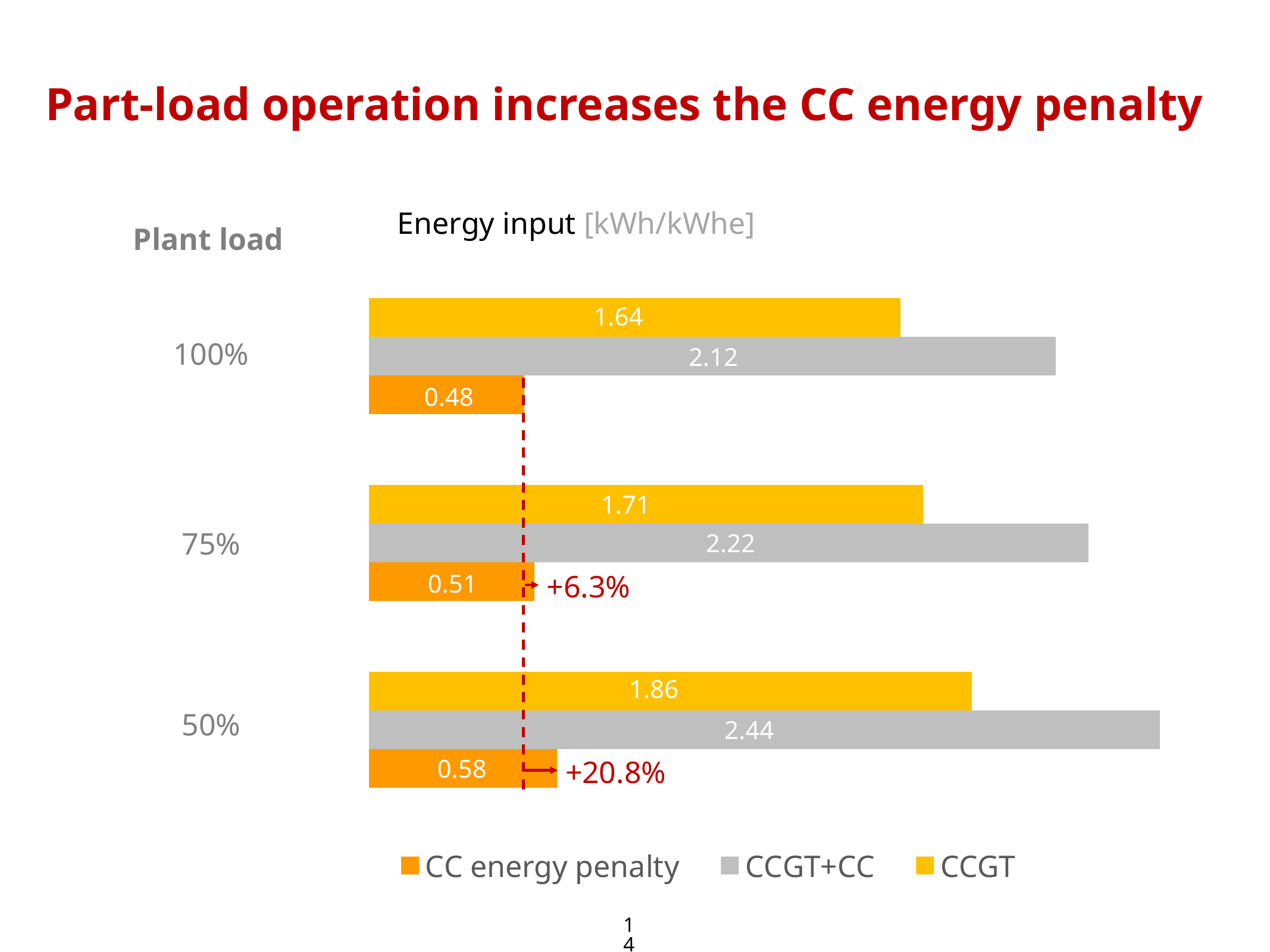
At which plant load is the CCGT+CC energy input lowest? 100% What percentage increase in CC energy penalty is annotated at 50% plant load? +20.8% What is the CC energy penalty at 75% plant load? 0.51 What is the difference between the CC energy penalty at 50% and at 100% plant load? 0.10 At which plant load is the CC energy penalty highest? 50% What kind of chart is shown on the slide? Bar chart What is the difference between the CCGT+CC and CCGT energy input at 75% plant load? 0.51 What is the CCGT energy input at 100% plant load? 1.64 How many plant load categories are shown in the chart? 3 What is the CCGT+CC energy input at 50% plant load? 2.44 Which is larger: the CCGT energy input at 50% plant load or the CCGT+CC energy input at 100% plant load? CCGT+CC at 100% How many series does the legend list? 3